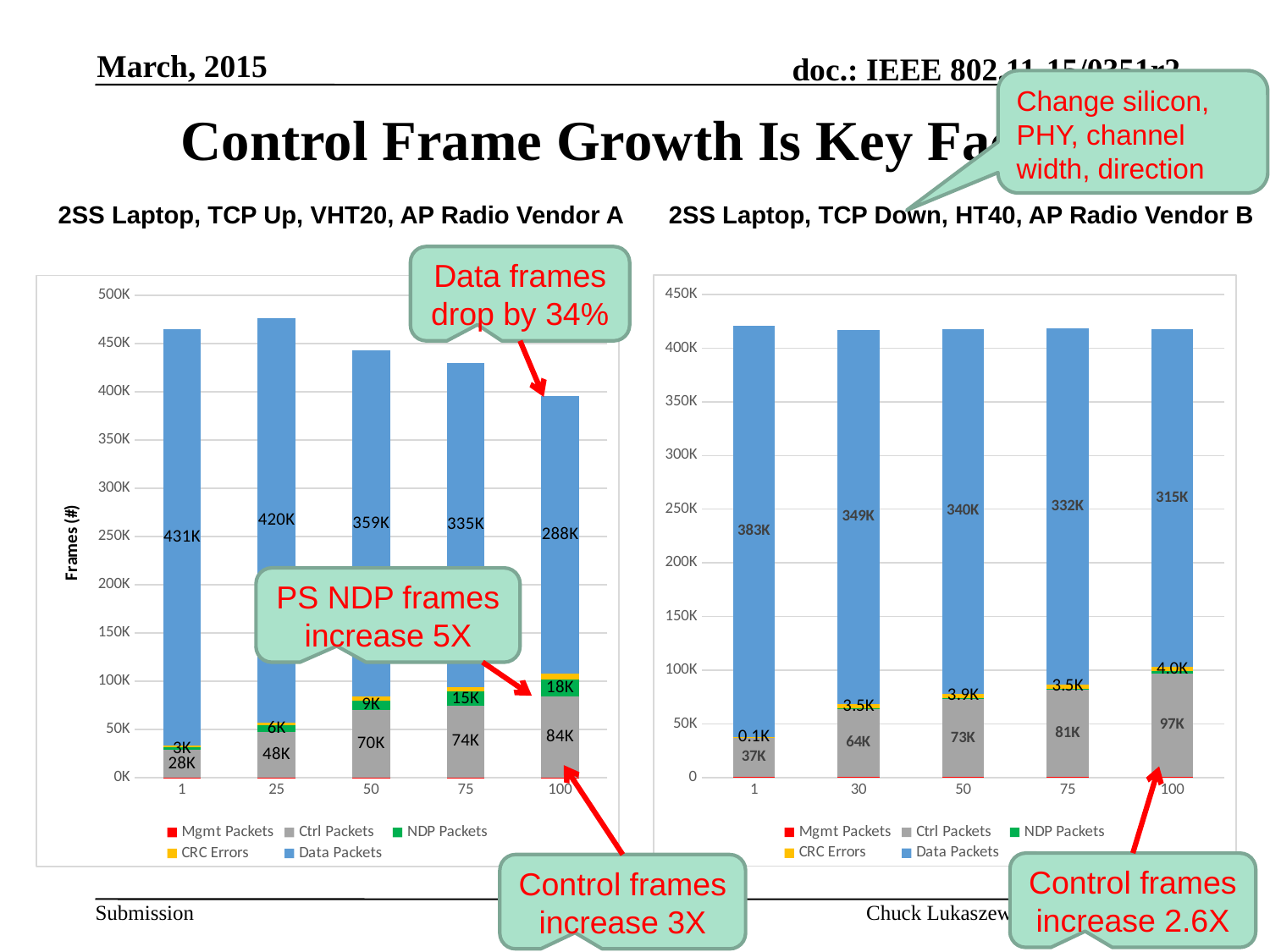
In the left chart (2SS Laptop, TCP Up, VHT20, AP Radio Vendor A), do the Ctrl Packets values rise or fall as the x-axis categories increase? rise In the left chart (2SS Laptop, TCP Up, VHT20, AP Radio Vendor A), which category has the lowest Data Packets value? 100 In the right chart (2SS Laptop, TCP Down, HT40, AP Radio Vendor B), how many categories are shown on the x-axis? 5 In the right chart (2SS Laptop, TCP Down, HT40, AP Radio Vendor B), which category has the highest Ctrl Packets value? 100 In the left chart (2SS Laptop, TCP Up, VHT20, AP Radio Vendor A), what is the difference between the Ctrl Packets values at category 100 and category 1? 56K In the right chart (2SS Laptop, TCP Down, HT40, AP Radio Vendor B), what is the Data Packets value at category 50? 340K In the left chart (2SS Laptop, TCP Up, VHT20, AP Radio Vendor A), what is the Ctrl Packets value at category 100? 84K What type of chart is the left chart (2SS Laptop, TCP Up, VHT20, AP Radio Vendor A)? stacked bar chart In the left chart (2SS Laptop, TCP Up, VHT20, AP Radio Vendor A), how many series does the legend list? 5 In the right chart (2SS Laptop, TCP Down, HT40, AP Radio Vendor B), which is larger: the Data Packets value at category 1 or at category 100? category 1 In the left chart (2SS Laptop, TCP Up, VHT20, AP Radio Vendor A), what is the Data Packets value at category 1? 431K In the right chart (2SS Laptop, TCP Down, HT40, AP Radio Vendor B), what is the Ctrl Packets value at category 75? 81K